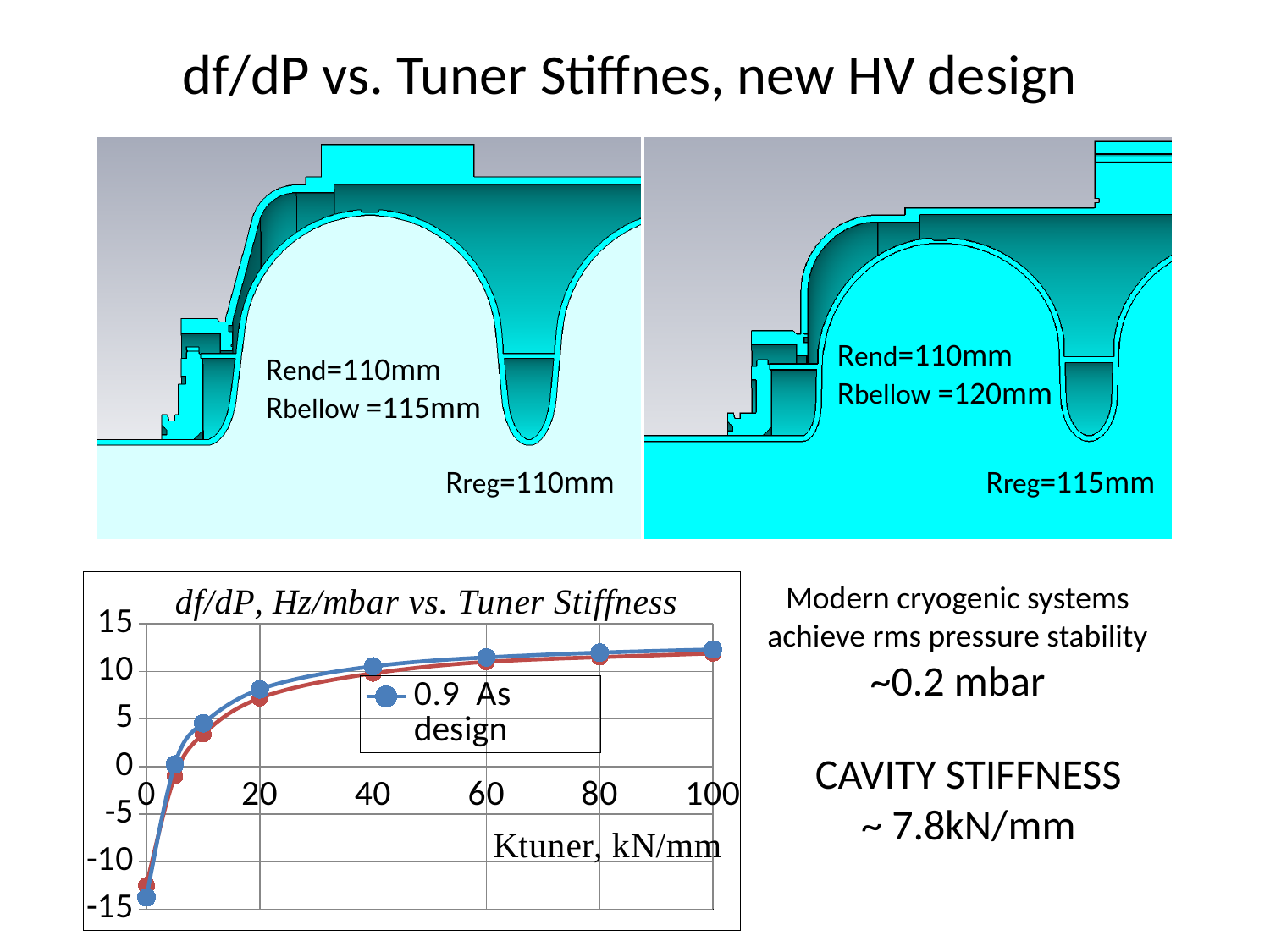
What is the title of the chart? df/dP, Hz/mbar vs. Tuner Stiffness What is the label of the x axis of the chart? Ktuner, kN/mm Is the value of the blue series at Ktuner = 0 greater or less than -10? less How many lines are plotted on the chart? 2 What kind of chart is shown on the slide? line chart Do the plotted values rise or fall as Ktuner increases along the x axis? rise Is the value of the red series at Ktuner = 60 greater or less than 10? greater Is the value of the blue series at Ktuner = 20 greater or less than 5? greater At which Ktuner value does the blue series reach its lowest point? 0 At Ktuner = 0, which series has the lower value, the blue or the red? blue At which Ktuner value does the blue series reach its highest point? 100